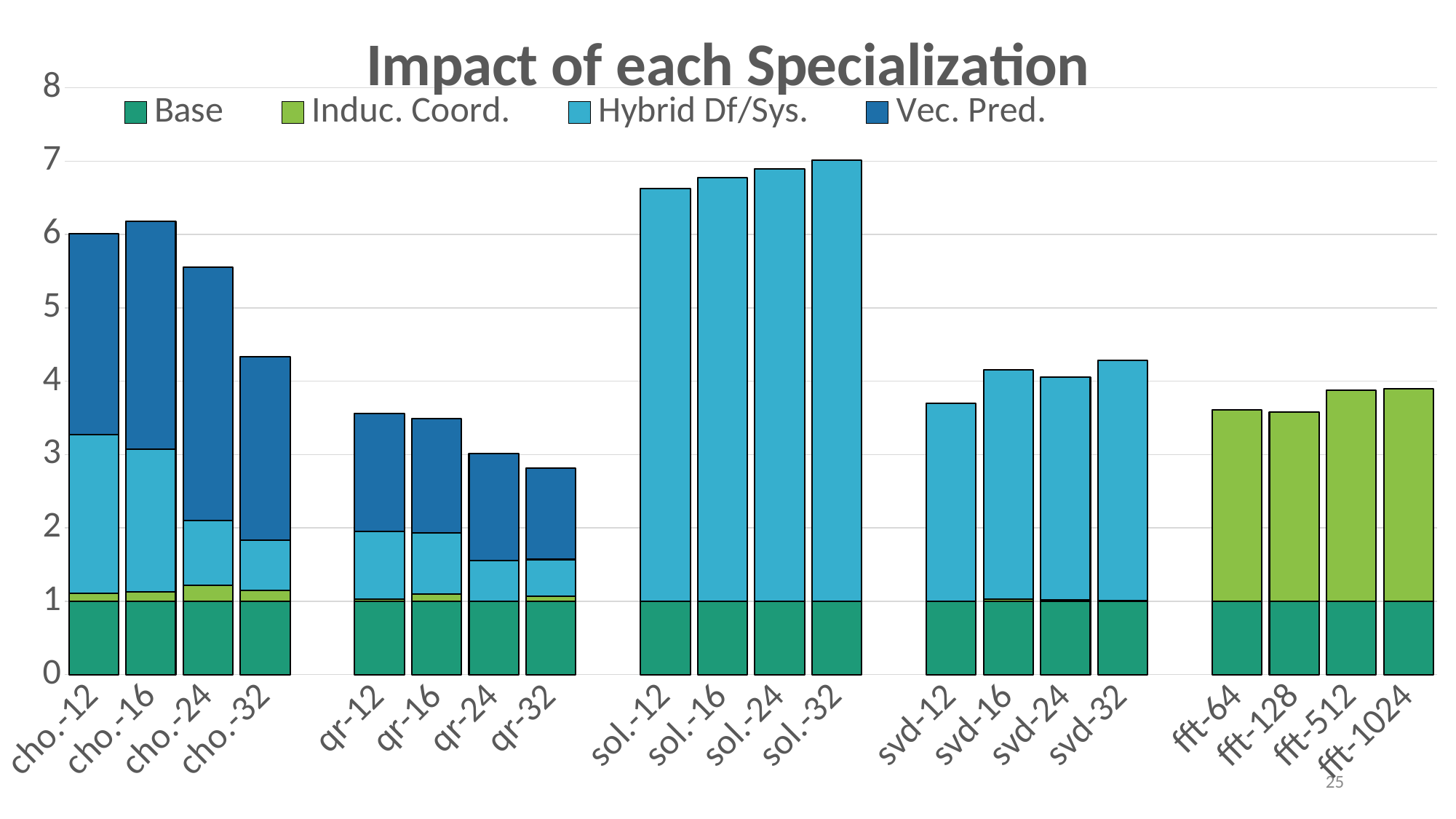
Is the total value for qr-32 greater or less than 3? less Is the total value for sol.-12 greater or less than 6? greater Which category has the shortest stacked bar? qr-32 Is the total value for fft-64 greater or less than 4? less What kind of chart is shown on the slide? Stacked bar chart How many categories are plotted along the x axis? 20 Which has the taller stacked bar, cho.-16 or cho.-24? cho.-16 Which category has the tallest stacked bar? sol.-32 Which series forms the bottom segment of every stacked bar? Base How many series does the legend list? 4 What is the title of the chart? Impact of each Specialization Do the stacked bar totals rise or fall from sol.-12 to sol.-32? rise